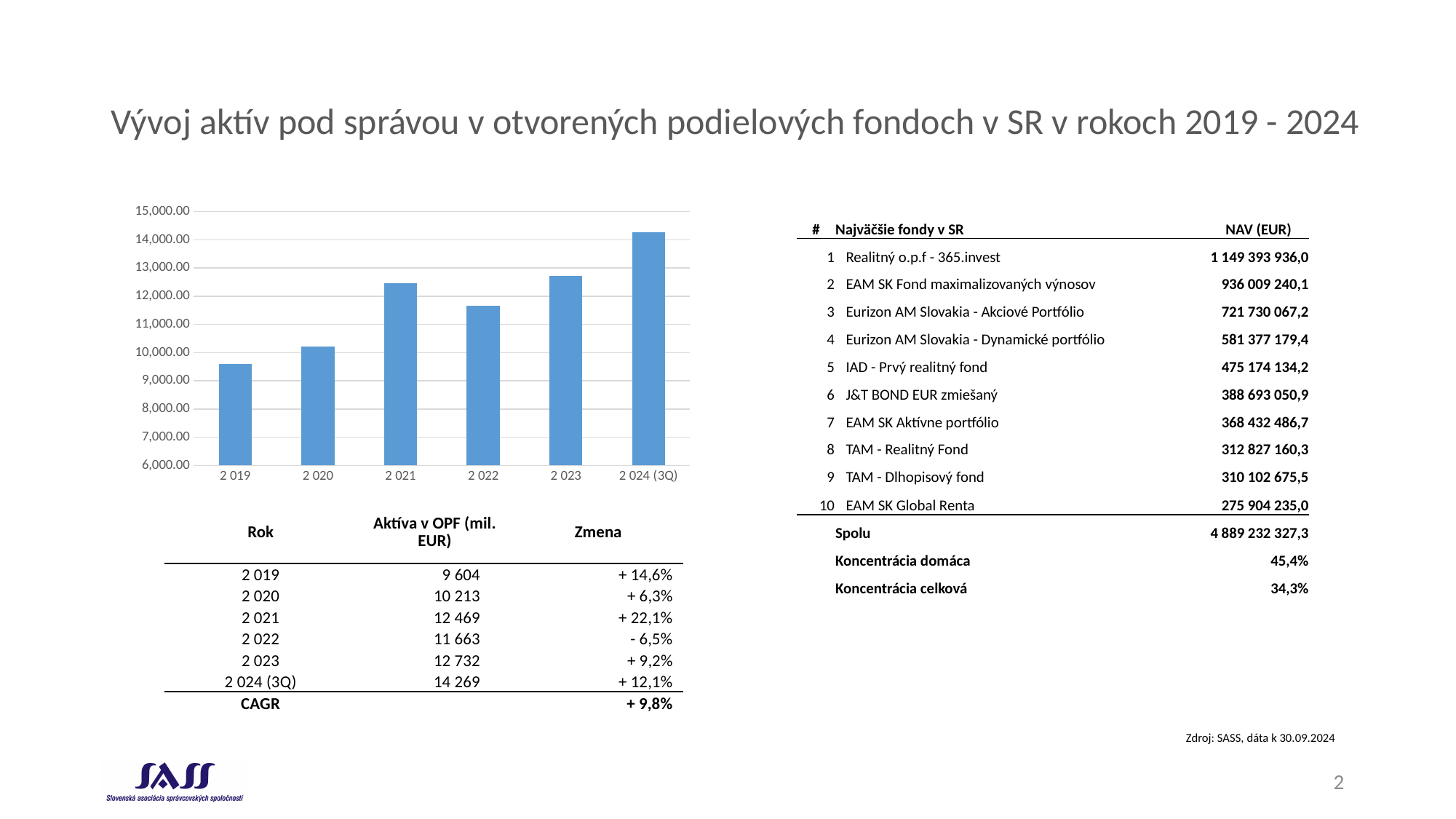
How many bars (years) are plotted in the chart? 6 Is the value for 2 022 greater or less than 11,000.00? greater Which bar is taller, 2 021 or 2 022? 2 021 Which year has the lowest bar in the chart? 2 019 What is the lowest value shown on the chart's vertical axis? 6,000.00 Which year has the highest bar in the chart? 2 024 (3Q) What kind of chart is shown on the slide? bar chart Is the value for 2 019 greater or less than 10,000.00? less According to the table under the chart, what is the value of assets in OPF (mil. EUR) for 2 021? 12 469 Is the value for 2 023 greater or less than 13,000.00? less Do the values in the chart generally rise or fall from 2 019 to 2 024 (3Q)? rise